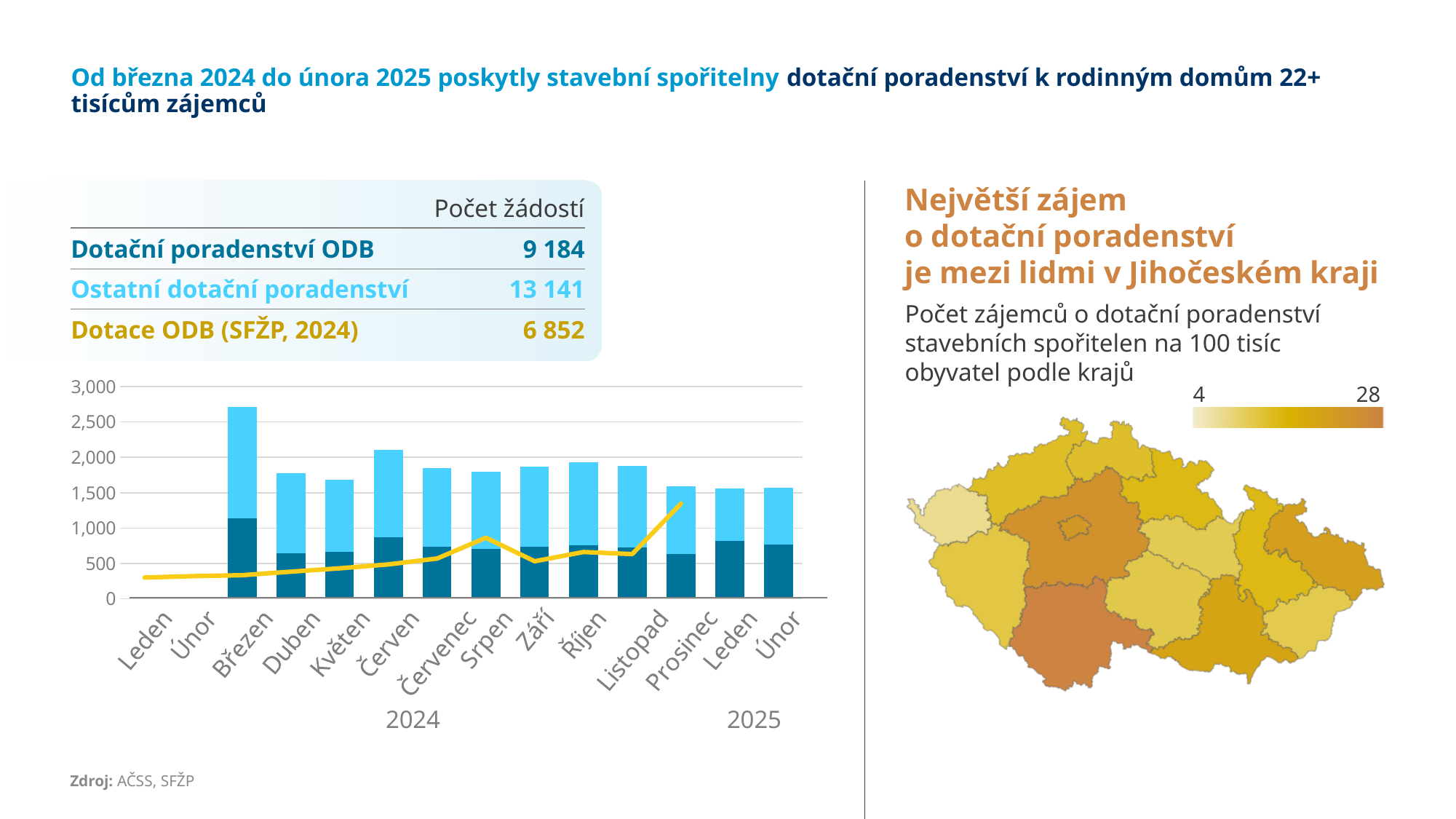
In the bar chart, is the dark blue segment for Březen 2024 greater or less than 1,000? greater In the table above the bar chart, what is the number of applications (Počet žádostí) for Ostatní dotační poradenství? 13 141 In the bar chart, is the total bar for Duben 2024 greater or less than 1,500? greater In the bar chart, which month has the tallest bar? Březen 2024 What kind of chart is shown on the left side of the slide below the table? combination bar and line chart (stacked bars with a line) On the map on the right, what are the minimum and maximum values shown on the colour scale? 4 and 28 In the bar chart, is the total bar for Květen 2024 greater or less than 2,000? less How many month labels are shown on the x axis of the bar chart? 14 In the table above the bar chart, what is the number of applications for Dotace ODB (SFŽP, 2024)? 6 852 Does the yellow line in the bar chart generally rise or fall from Leden 2024 to Listopad 2024? rise